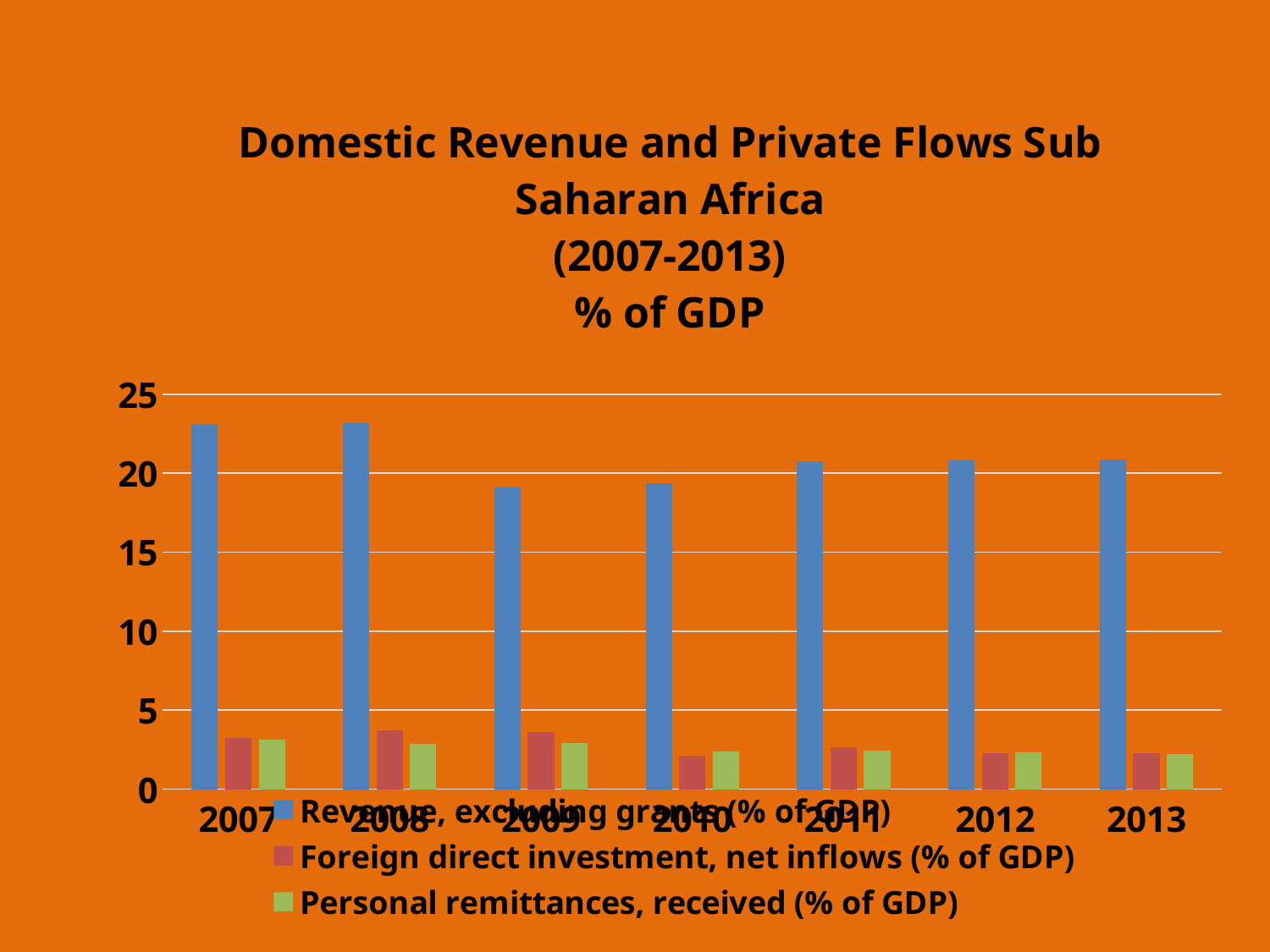
Is the value for Revenue, excluding grants in 2012 greater or less than 15? greater How many years are shown on the x axis of the chart? 7 What kind of chart is shown on the slide? bar chart Is the value for Revenue, excluding grants in 2007 greater or less than 20? greater Which is larger: Revenue, excluding grants in 2007 or in 2009? 2007 Do the values for Personal remittances, received generally rise or fall from 2007 to 2013? fall In 2011, which series has the larger value: Revenue, excluding grants or Personal remittances, received? Revenue, excluding grants How many series does the chart's legend list? 3 Is the value for Foreign direct investment, net inflows in 2008 greater or less than 5? less Which series is shown in green in the chart's legend? Personal remittances, received (% of GDP) Which is larger: Foreign direct investment, net inflows in 2008 or in 2010? 2008